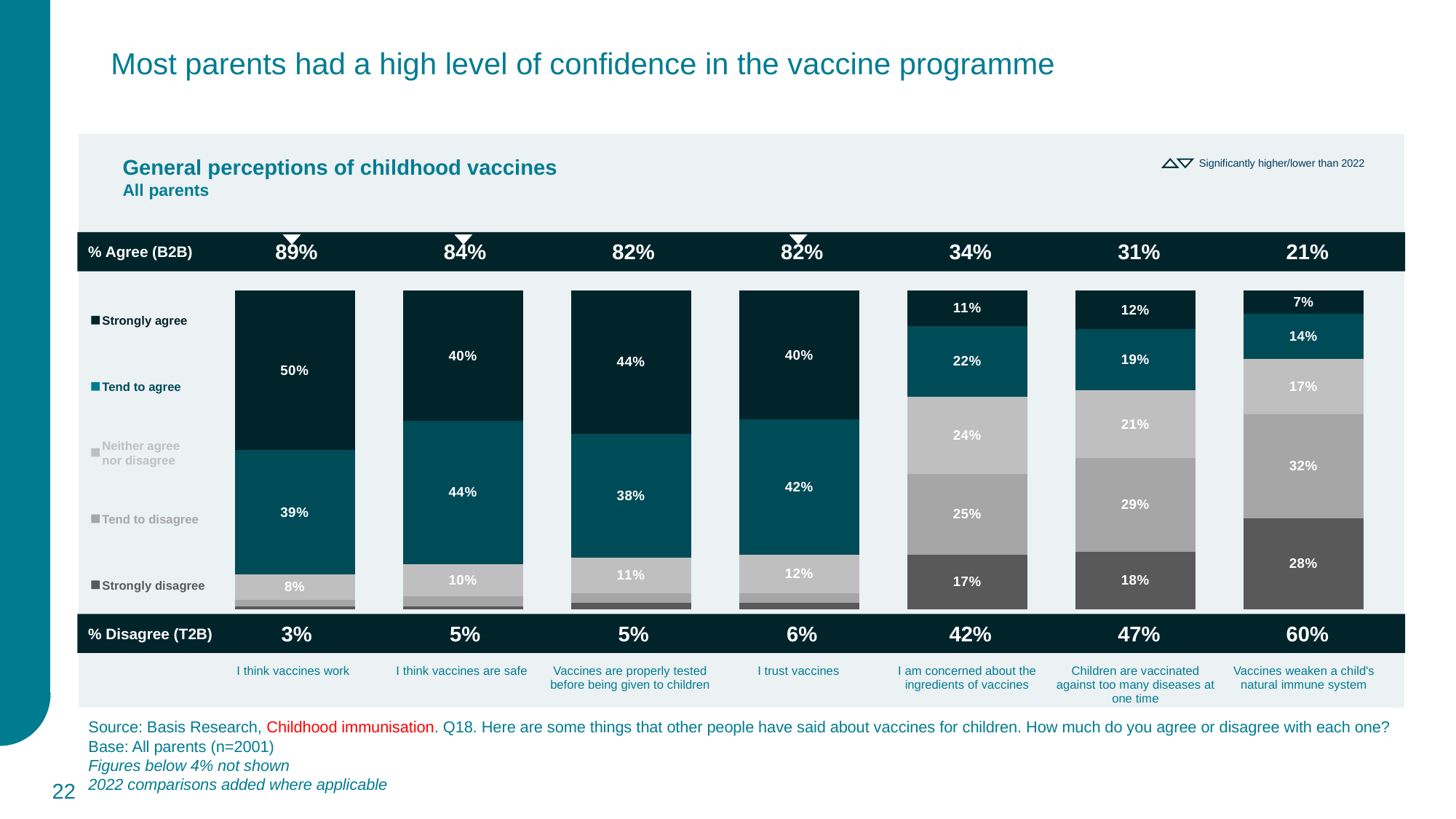
Which statement has the lowest % Agree (B2B)? Vaccines weaken a child's natural immune system What percentage of parents strongly agree with "I think vaccines work"? 50% What is the % Disagree (T2B) figure for "Children are vaccinated against too many diseases at one time"? 47% Which statement has the highest % Agree (B2B)? I think vaccines work How many response categories does the legend list? 5 What percentage of parents strongly disagree with "Vaccines weaken a child's natural immune system"? 28% Which is larger: the "Tend to agree" share for "I think vaccines are safe" or for "Vaccines are properly tested before being given to children"? I think vaccines are safe How many statements are shown in the chart? 7 What is the difference between the % Disagree (T2B) for "Vaccines weaken a child's natural immune system" and for "I am concerned about the ingredients of vaccines"? 18% What is the % Agree (B2B) figure for "I think vaccines are safe"? 84% What is the subtitle under the chart title "General perceptions of childhood vaccines"? All parents What type of chart is used to show the general perceptions of childhood vaccines? Stacked bar chart